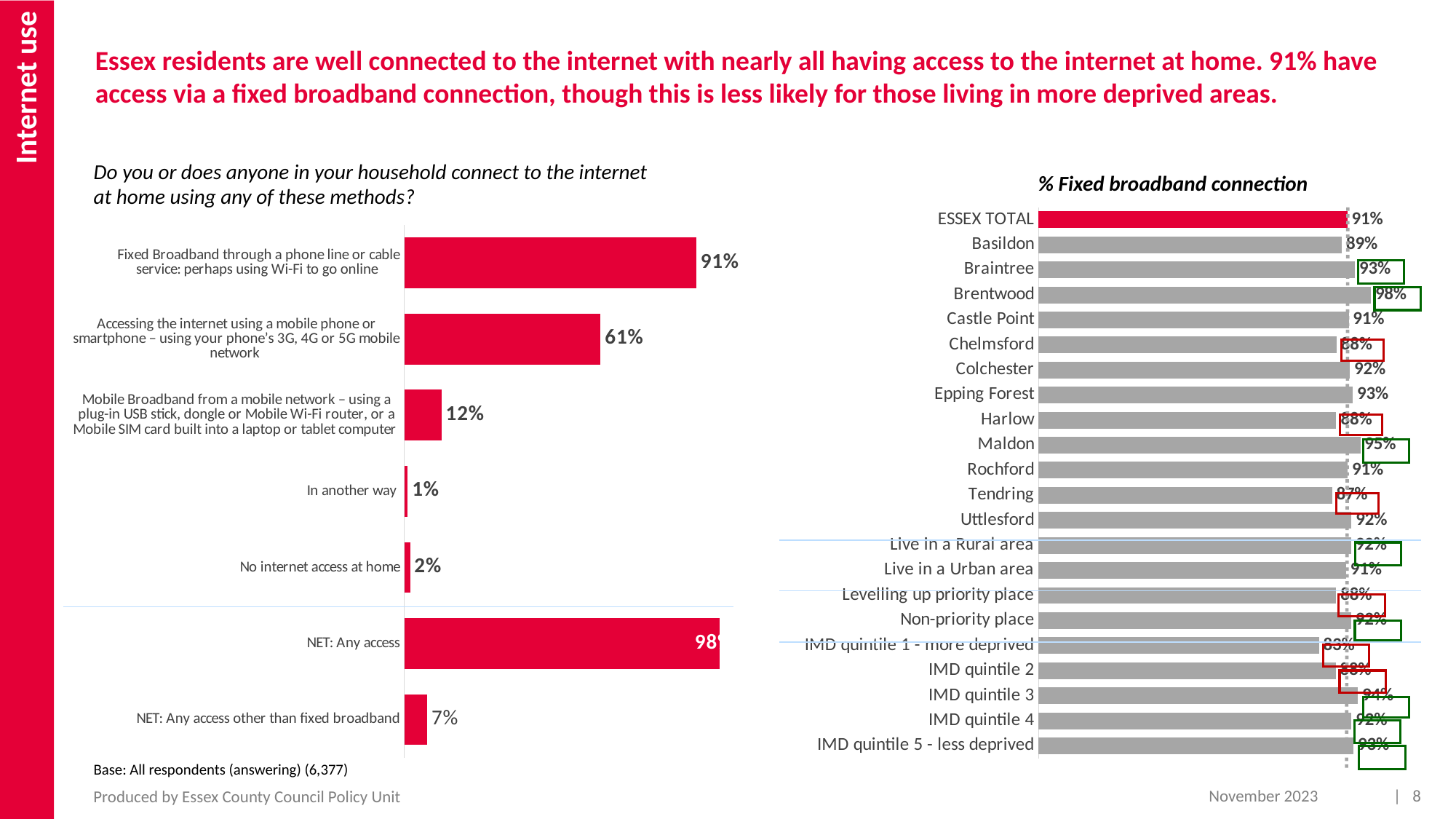
In the left chart, which method has the lowest percentage? In another way In the '% Fixed broadband connection' chart, what is the value for Maldon? 95% In the left chart, what is the value for 'NET: Any access'? 98% In the '% Fixed broadband connection' chart, what is the value for ESSEX TOTAL? 91% How many categories are shown in the left chart? 7 In the left chart, what is the difference between fixed broadband (91%) and mobile phone access (61%)? 30 percentage points In the left chart, what percentage of respondents use fixed broadband through a phone line or cable service? 91% In the '% Fixed broadband connection' chart, which is higher: Basildon or Braintree? Braintree In the left chart, what percentage access the internet using a mobile phone or smartphone? 61% In the left chart, what is the value for 'No internet access at home'? 2% In the '% Fixed broadband connection' chart, which area has the highest value? Brentwood What type of chart is the '% Fixed broadband connection' chart? Bar chart